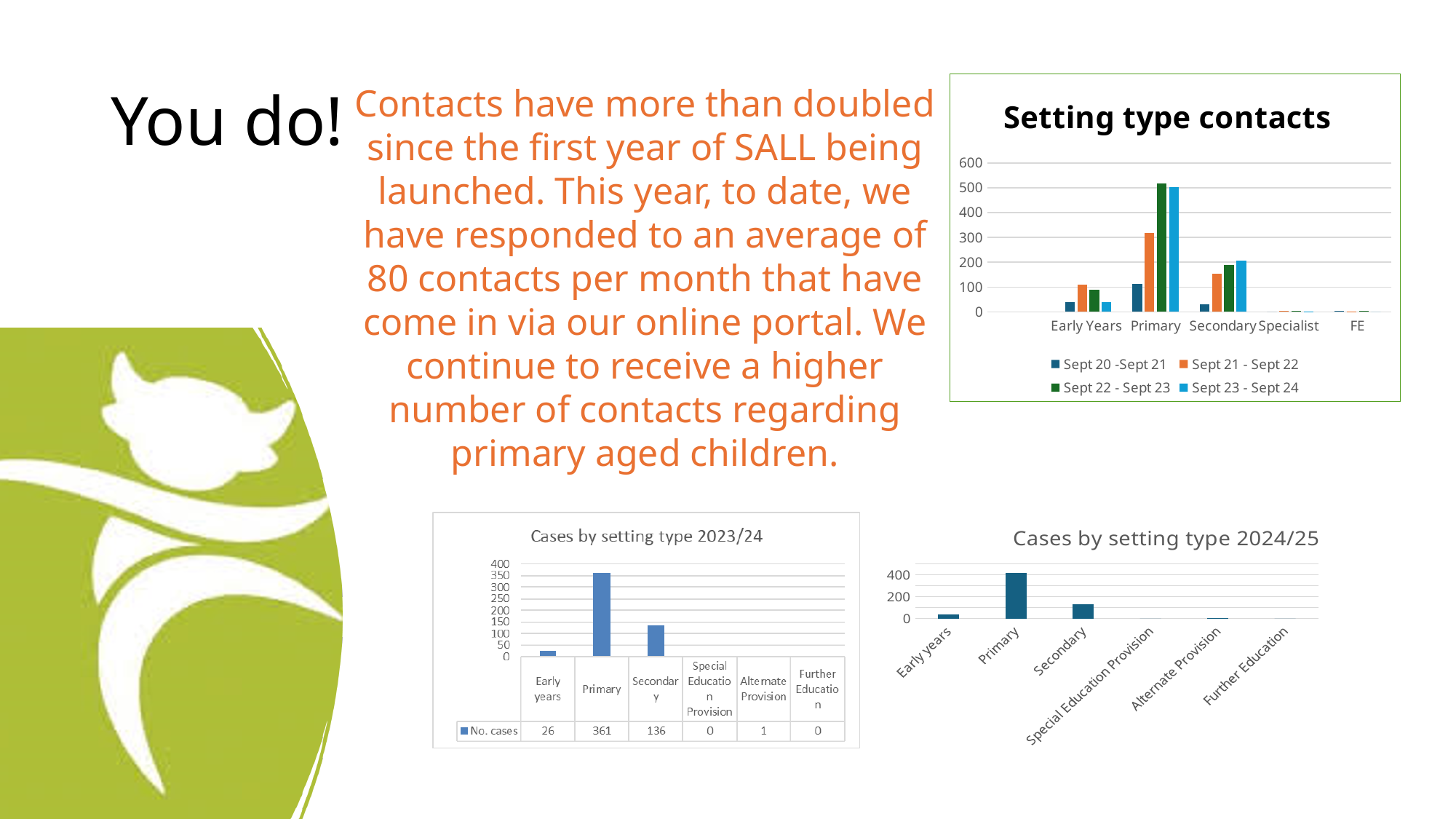
In the 'Cases by setting type 2024/25' chart, is the value for Secondary greater or less than 200? less In the 'Setting type contacts' chart, is the Secondary value for Sept 20 - Sept 21 greater or less than 100? less How many series does the legend of the 'Setting type contacts' chart list? 4 In the 'Cases by setting type 2023/24' chart, how many cases were there for Primary? 361 In the 'Cases by setting type 2023/24' chart, what is the difference in cases between Primary and Secondary? 225 In the 'Cases by setting type 2023/24' chart, how many cases were there for Alternate Provision? 1 What kind of chart is the 'Setting type contacts' chart? Bar chart In the 'Cases by setting type 2023/24' chart, how many cases were there for Secondary? 136 In the 'Setting type contacts' chart, which setting type has the highest contacts for Sept 23 - Sept 24? Primary In the 'Setting type contacts' chart, is the Primary value for Sept 21 - Sept 22 greater or less than 300? greater In the 'Cases by setting type 2023/24' chart, how many setting type categories are shown? 6 In the 'Cases by setting type 2023/24' chart, which setting type has the highest number of cases? Primary